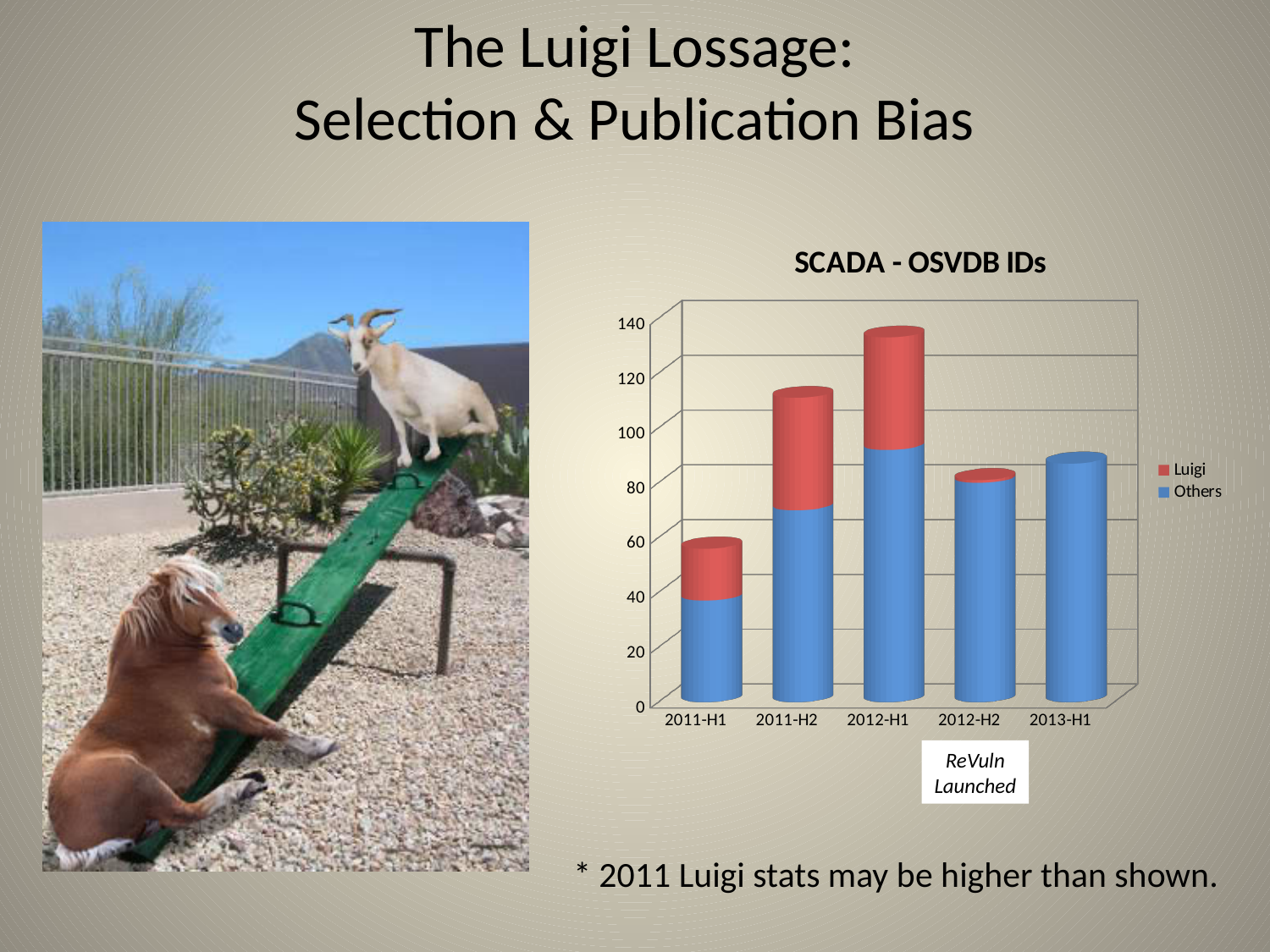
Which has the larger total bar, 2011-H2 or 2012-H2? 2011-H2 How many categories are shown on the x axis of the chart? 5 What is the title of the chart? SCADA - OSVDB IDs Is the total value for 2011-H2 greater or less than 100? greater Which period has the highest total bar in the chart? 2012-H1 Is the total value for 2012-H1 greater or less than 120? greater Which period has the lowest total bar in the chart? 2011-H1 Which series is shown in red in the chart? Luigi How many series does the chart's legend list? 2 What kind of chart is shown on the slide? Stacked bar chart Is the total value for 2011-H1 greater or less than 80? less